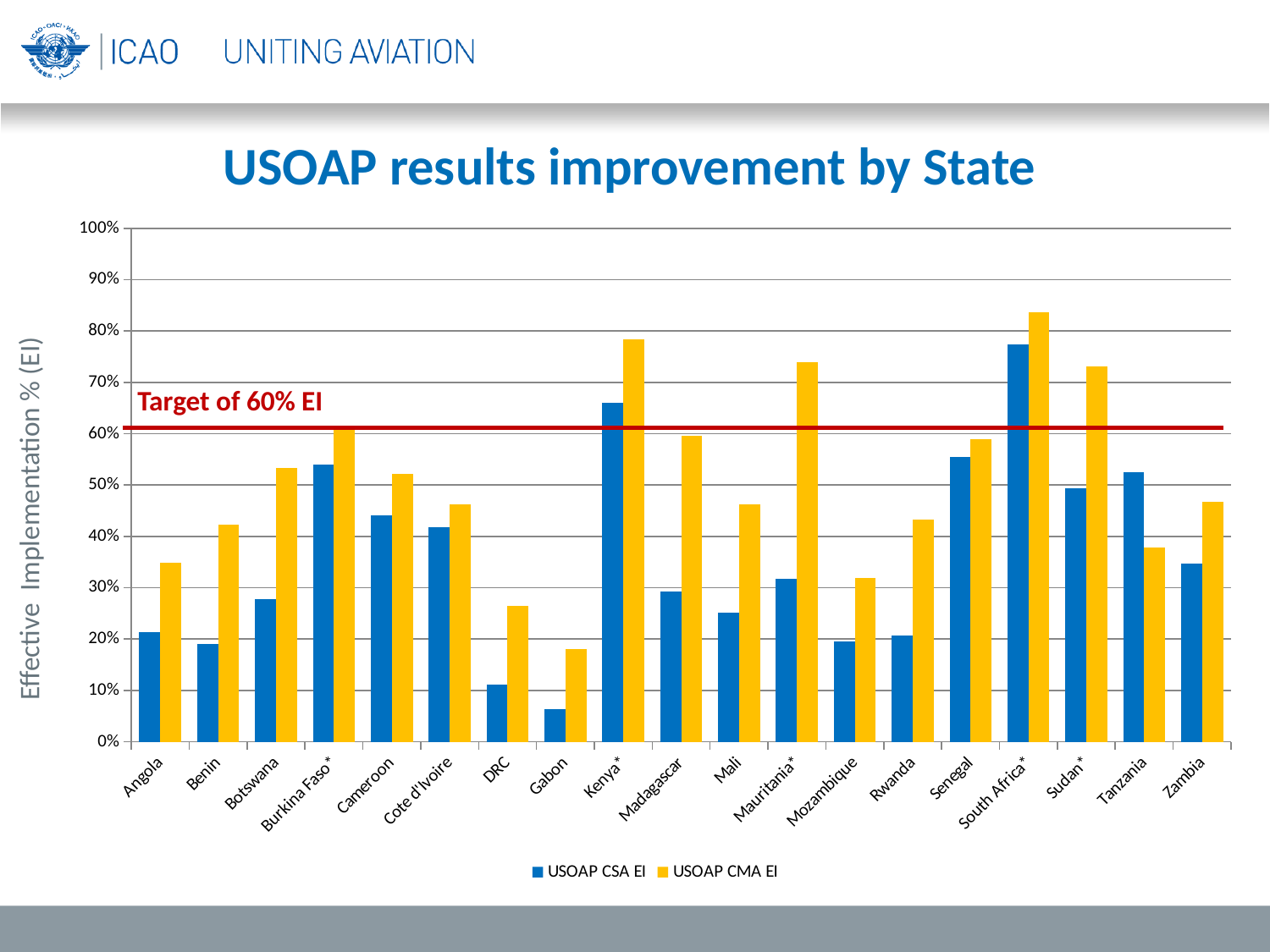
Which State has the lowest USOAP CSA EI value? Gabon For Tanzania, which is larger: the USOAP CSA EI or the USOAP CMA EI? USOAP CSA EI Which State has the highest USOAP CMA EI value? South Africa* Which is larger: the USOAP CMA EI for Benin or for Botswana? Botswana Is the USOAP CSA EI value for Botswana greater or less than 30%? less Is the USOAP CSA EI value for Gabon greater or less than 10%? less How many States are shown on the x axis? 19 What target EI level does the red horizontal line mark? 60% EI Is the USOAP CMA EI value for Kenya* greater or less than 70%? greater How many series does the legend list? 2 Which State has the lowest USOAP CMA EI value? Gabon What kind of chart is shown on the slide? bar chart